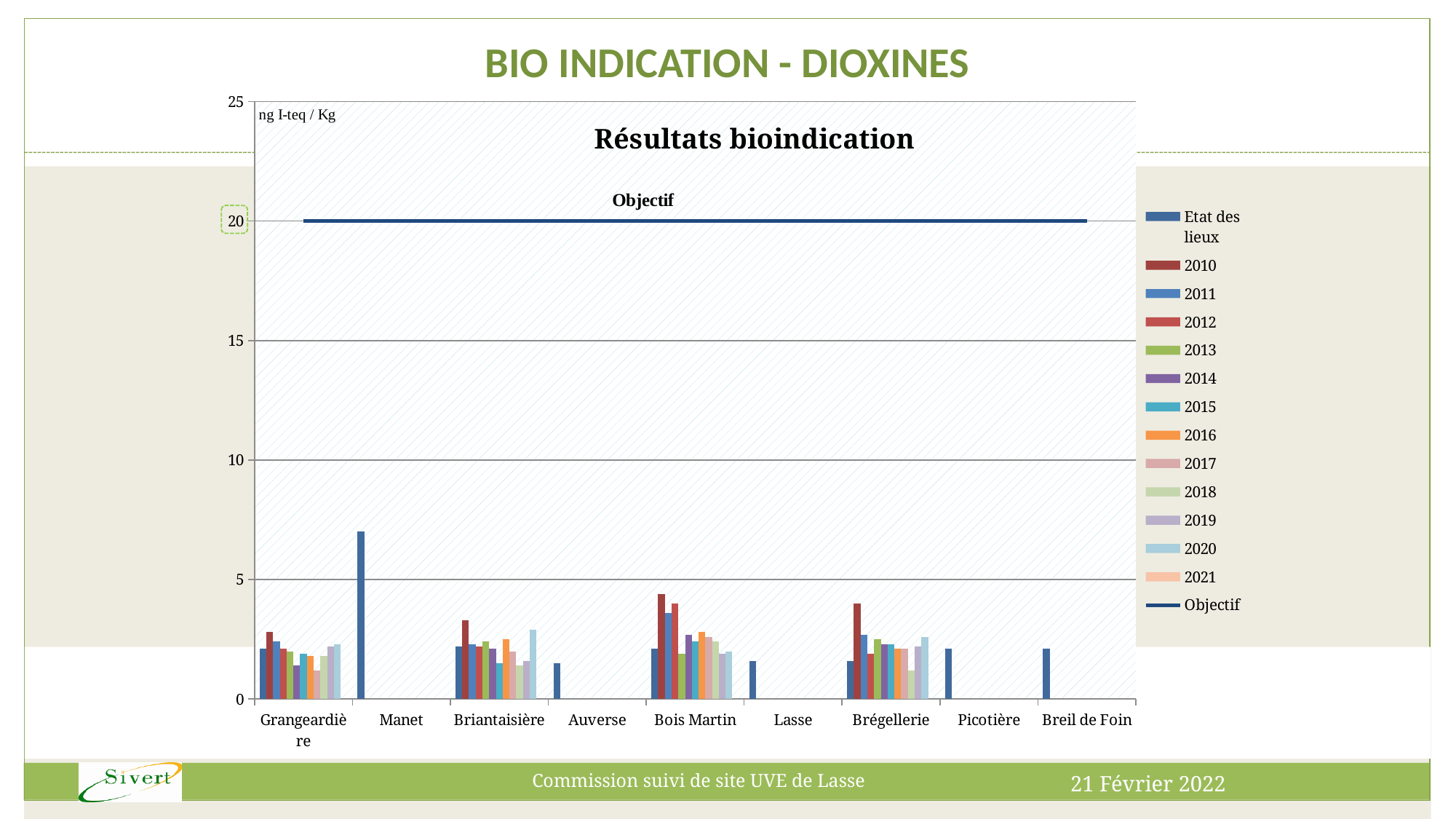
What is the value of the Objectif line? 20 What unit is shown on the chart's y axis? ng I-teq / Kg Is the 2010 value for Bois Martin greater or less than 5? less Is the Etat des lieux value for Grangeardière greater or less than 5? less Which is larger, the 2010 value for Bois Martin or for Briantaisière? Bois Martin Which is larger, the Etat des lieux value for Manet or for Breil de Foin? Manet What kind of chart is shown on the slide? combination bar and line chart How many entries does the legend list? 14 What is the title of the chart? Résultats bioindication Which site has the highest Etat des lieux value? Manet How many categories (sites) are shown on the x axis? 9 Is the Etat des lieux value for Manet greater or less than 5? greater